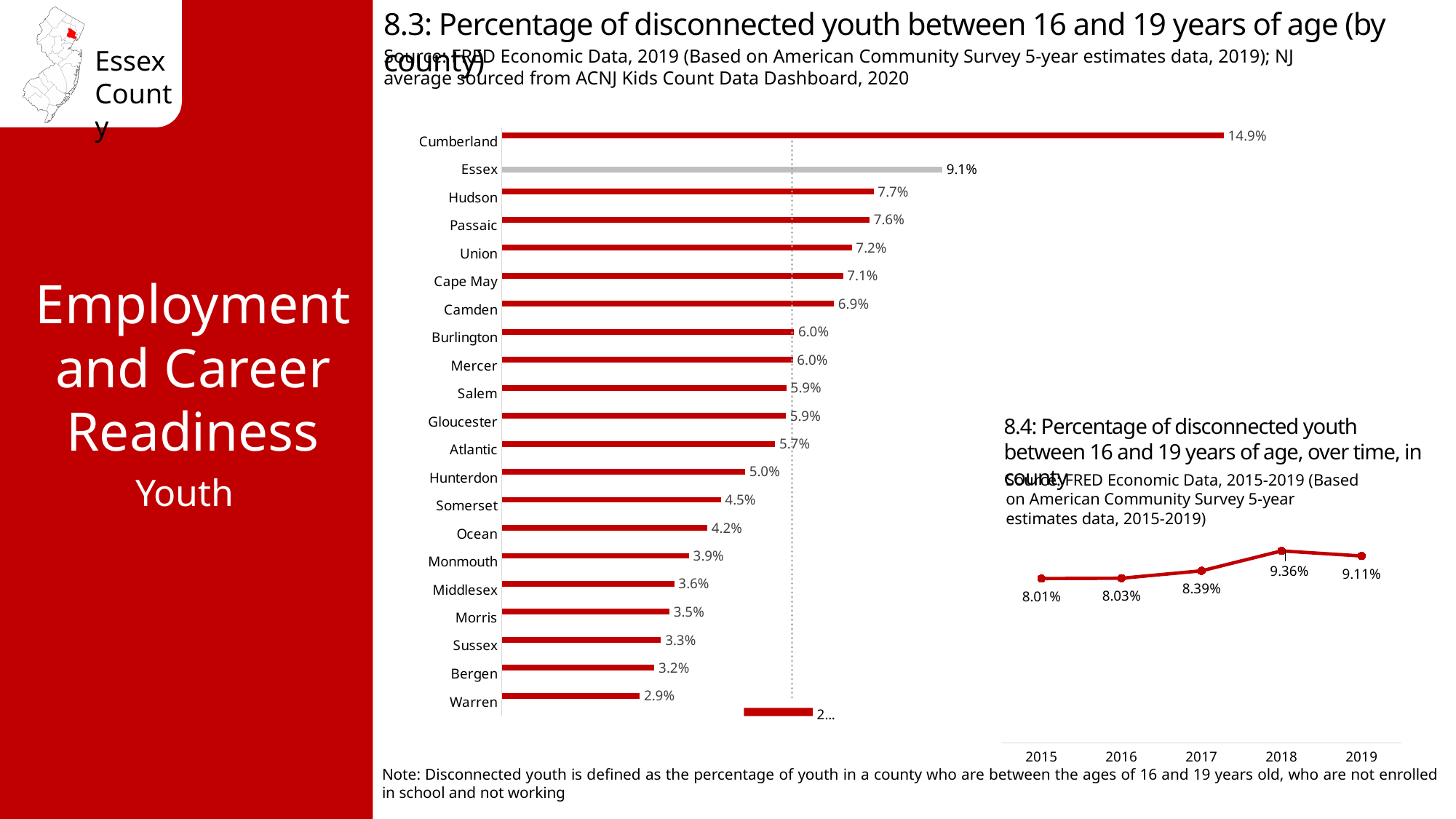
In chart 8.3 (percentage of disconnected youth by county), what is the value for Hudson? 7.7% In chart 8.4 (percentage of disconnected youth over time), what is the value for 2018? 9.36% In chart 8.4 (percentage of disconnected youth over time), which year has the lowest value? 2015 In chart 8.3 (percentage of disconnected youth by county), what is the value for Essex? 9.1% In chart 8.3 (percentage of disconnected youth by county), what is the difference between Cumberland and Essex? 5.8% In chart 8.3 (percentage of disconnected youth by county), which is larger, the value for Passaic or the value for Camden? Passaic In chart 8.4 (percentage of disconnected youth over time), what is the difference between the 2019 and 2015 values? 1.10% In chart 8.3 (percentage of disconnected youth by county), which county has the highest value? Cumberland In chart 8.3 (percentage of disconnected youth by county), how many counties are shown? 21 In chart 8.3 (percentage of disconnected youth by county), which county has the lowest value? Warren In chart 8.4 (percentage of disconnected youth over time), how many years are plotted? 5 What kind of chart is chart 8.3 (percentage of disconnected youth by county)? Bar chart